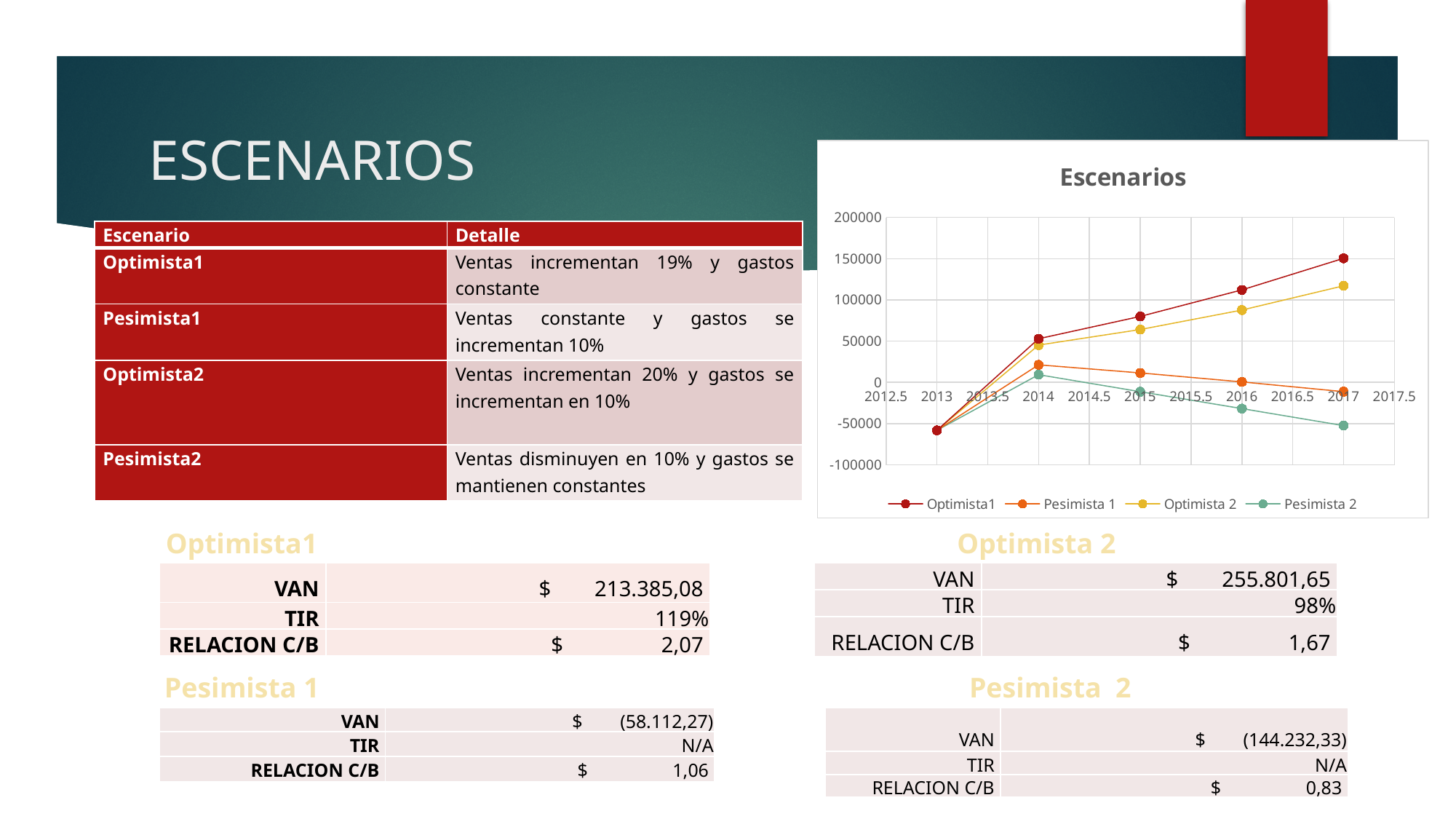
How many series does the legend of the "Escenarios" chart list? 4 In the "Escenarios" chart, which is larger at 2017: Optimista1 or Optimista 2? Optimista1 In the "Escenarios" chart, does the Pesimista 1 series rise or fall from 2014 to 2017? fall In the "Escenarios" chart, is the value for Optimista1 at 2017 greater or less than 100000? greater In the "Escenarios" chart, which series has the highest value at 2017? Optimista1 What is the title of the line chart on the slide? Escenarios In the "Escenarios" chart, is the value for Pesimista 2 at 2017 greater or less than 0? less In the "Escenarios" chart, which series has the lowest value at 2017? Pesimista 2 How many data points does the Optimista1 series have in the "Escenarios" chart? 5 What kind of chart is the "Escenarios" chart? line chart In the "Escenarios" chart, is the value for Optimista1 at 2015 greater or less than 50000? greater In the "Escenarios" chart, does the Optimista1 series rise or fall from 2013 to 2017? rise